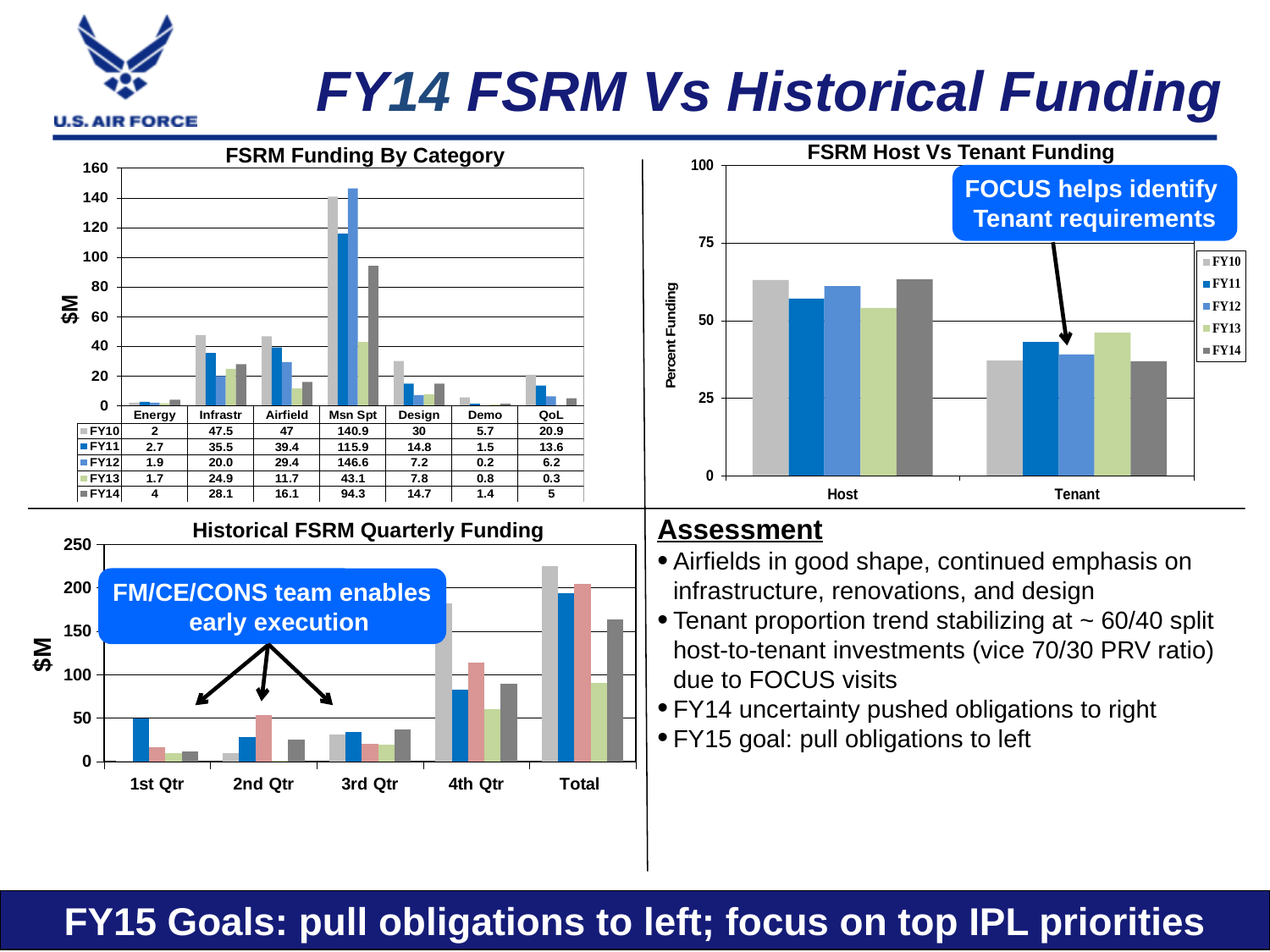
How many categories are shown on the x axis of the Historical FSRM Quarterly Funding chart? 5 In the FSRM Funding By Category chart, which category has the lowest FY13 value? QoL In the FSRM Funding By Category chart, what is the FY10 value for Infrastr? 47.5 In the FSRM Host Vs Tenant Funding chart, is the FY14 value for Tenant greater or less than 50? less In the FSRM Funding By Category chart, which category has the highest FY14 value? Msn Spt In the FSRM Funding By Category chart, which is larger for QoL: the FY10 value or the FY11 value? FY10 How many series does the legend of the FSRM Funding By Category chart list? 5 What kind of chart is the Historical FSRM Quarterly Funding chart? bar chart In the FSRM Host Vs Tenant Funding chart, is the FY10 value for Host greater or less than 50? greater How many categories are shown on the x axis of the FSRM Funding By Category chart? 7 In the FSRM Funding By Category chart, what is the difference between the FY10 and FY11 values for Airfield? 7.6 In the FSRM Funding By Category chart, what is the FY12 value for Msn Spt? 146.6